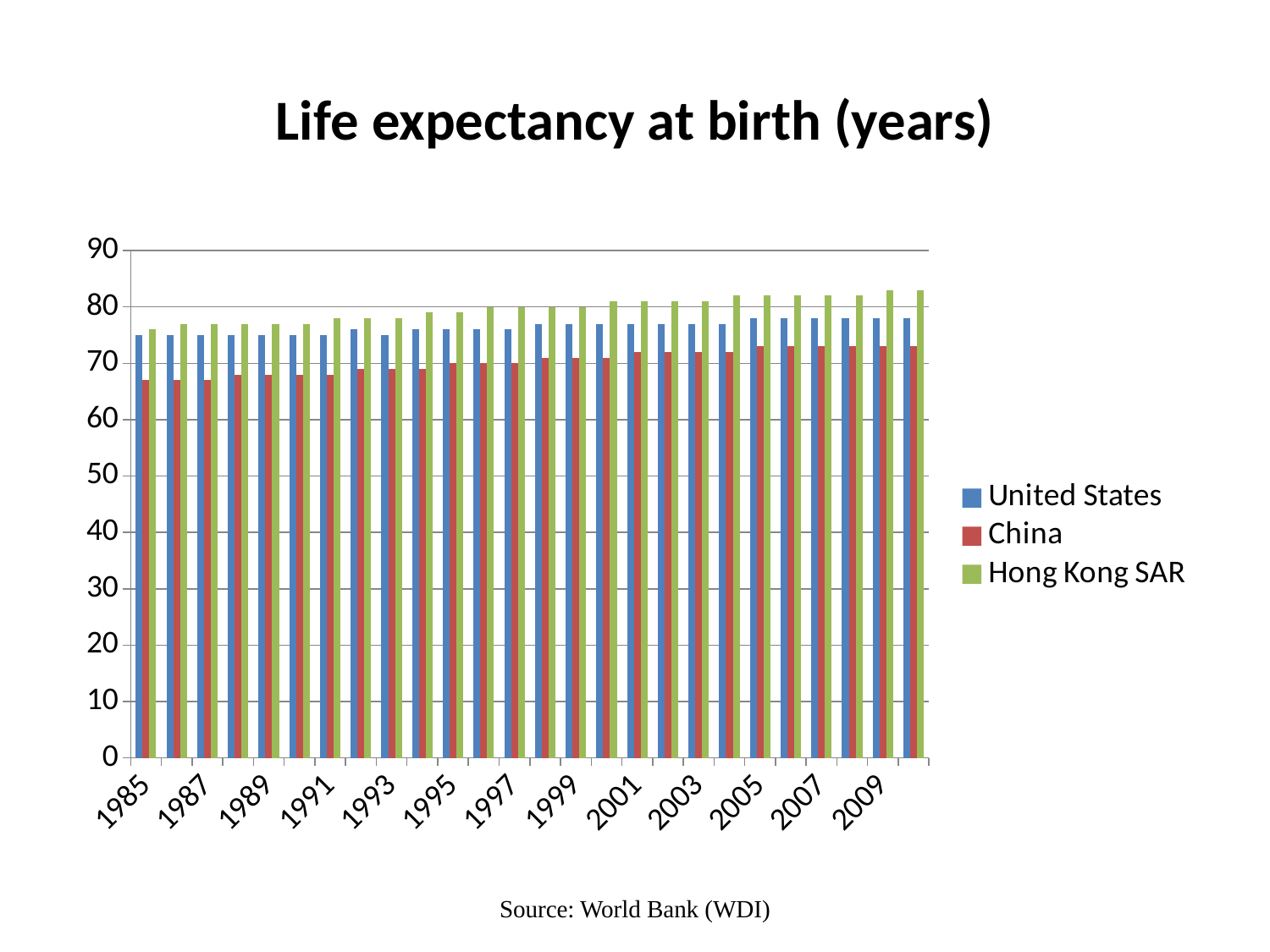
Is the value for Hong Kong SAR in 2009 greater or less than 80? greater How many series does the legend list? 3 Is the value for China in 1985 greater or less than 70? less In 2005, which is larger: the value for Hong Kong SAR or the value for China? Hong Kong SAR What is the title of the chart? Life expectancy at birth (years) Which series has the lowest value in 1985? China Which series has the highest value in 2009? Hong Kong SAR Do the values for China rise or fall from 1985 to 2009? rise Which series is shown in green in the legend? Hong Kong SAR Is the value for Hong Kong SAR in 1985 greater or less than 80? less What kind of chart is shown on the slide? bar chart